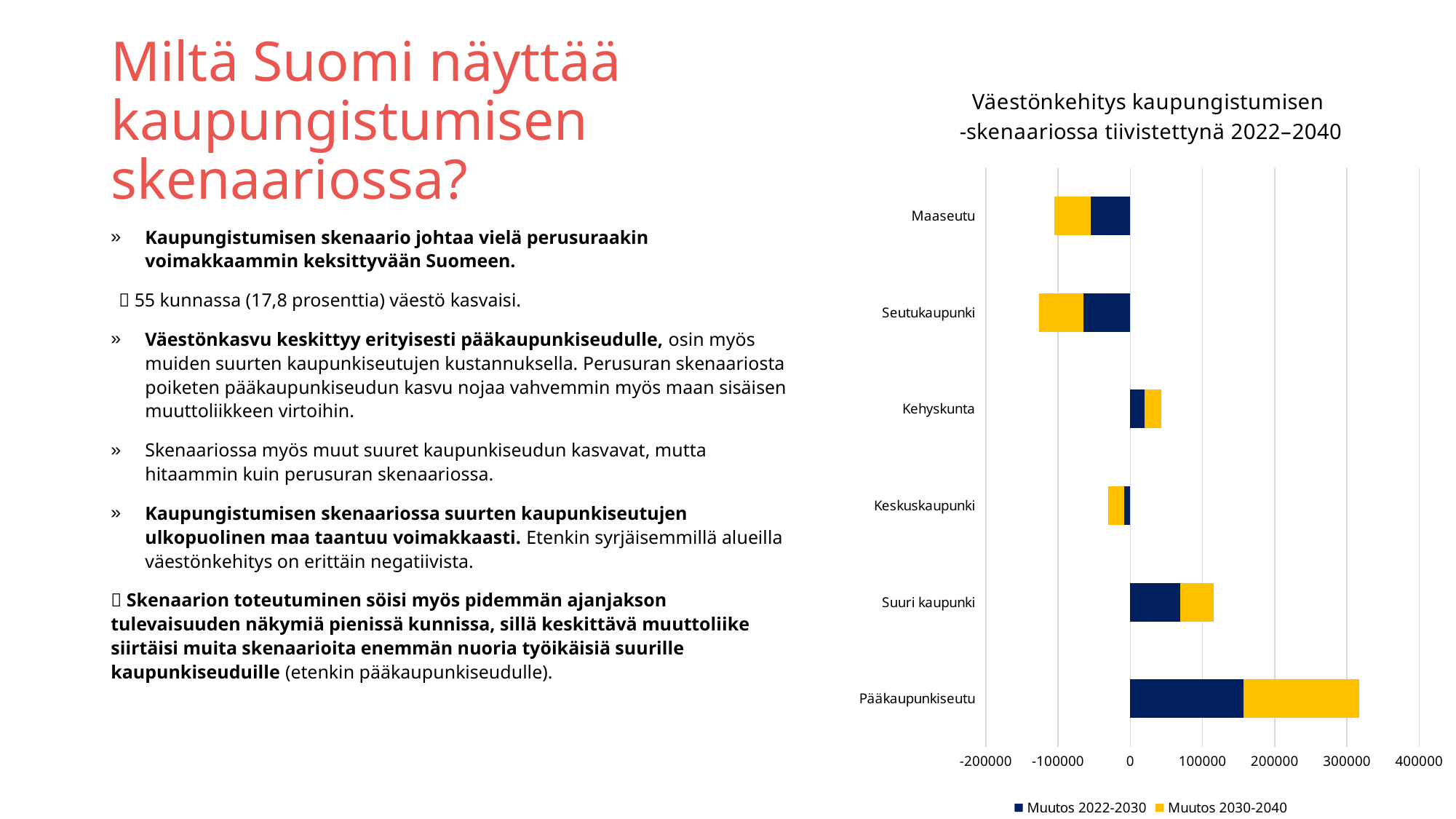
Is the value for Suuri kaupunki in Muutos 2022-2030 greater or less than 100000? less How many series does the chart legend list? 2 How many categories are shown on the chart? 6 Which is larger for Muutos 2030-2040: Kehyskunta or Keskuskaupunki? Kehyskunta Which category has the lowest combined value across both periods? Seutukaupunki Is the value for Pääkaupunkiseutu in Muutos 2022-2030 greater or less than 100000? greater Which is larger for Muutos 2022-2030: Pääkaupunkiseutu or Suuri kaupunki? Pääkaupunkiseutu What is the title of the chart? Väestönkehitys kaupungistumisen -skenaariossa tiivistettynä 2022–2040 What kind of chart is shown on the slide? Bar chart Is the combined value for Seutukaupunki across both periods greater or less than -100000? less Which colour represents the series Muutos 2030-2040? Yellow Which category has the highest value for Muutos 2022-2030? Pääkaupunkiseutu